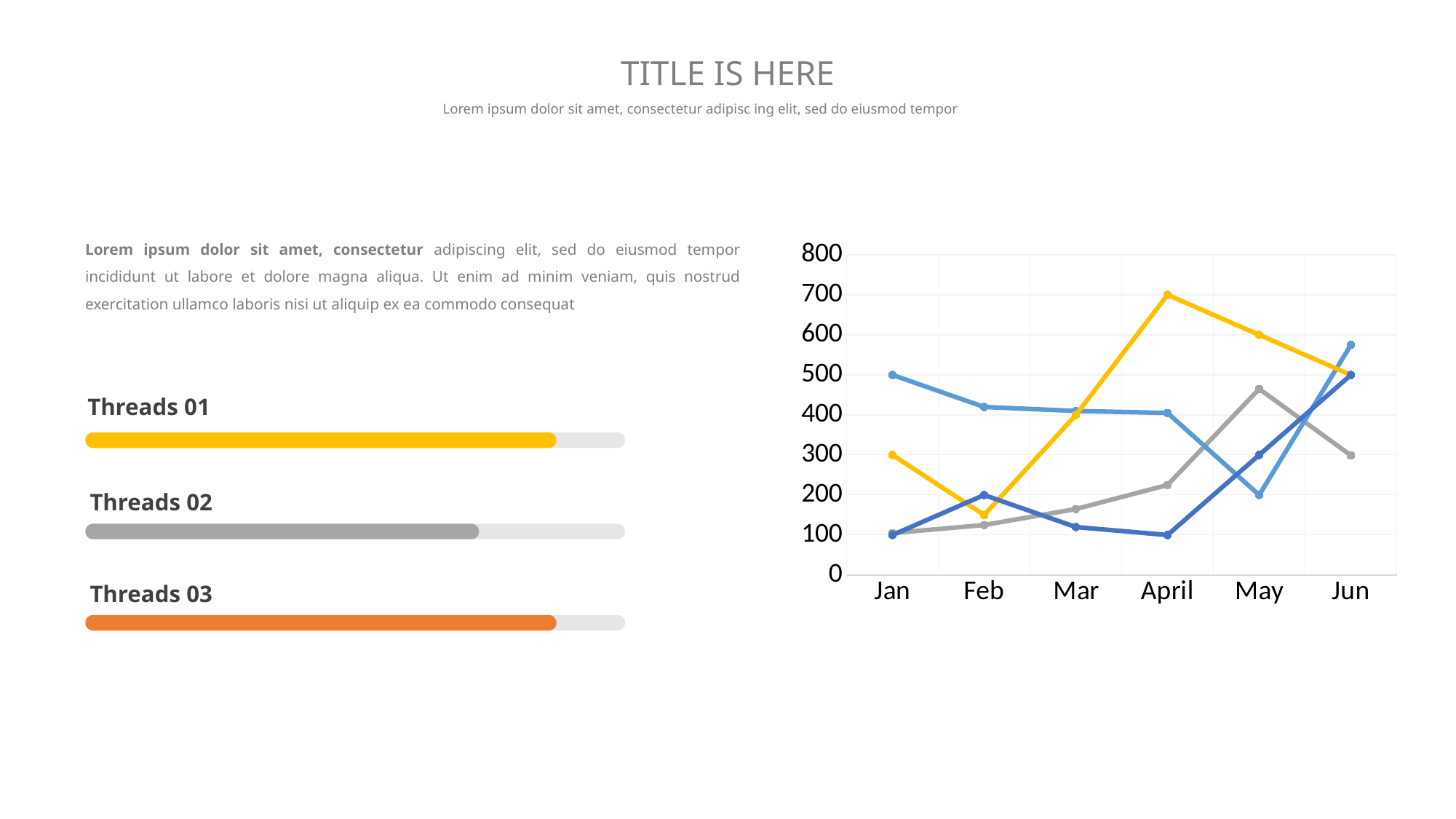
Does the yellow line rise or fall from April to Jun? fall What is the value of the light blue line in Jan? 500 Is the value of the light blue line in May greater or less than 300? less What kind of chart is shown on the right of the slide? line chart Is the value of the gray line in May greater or less than 400? greater How many months are shown on the x axis of the line chart? 6 What is the difference between the yellow line's value in April and its value in Jun? 200 In which month does the yellow line reach its highest value? April Which line has the higher value in April, the yellow line or the gray line? yellow line Does the gray line rise or fall from Jan to April? rise What is the value of the yellow line in Jan? 300 What is the value of the yellow line in April? 700